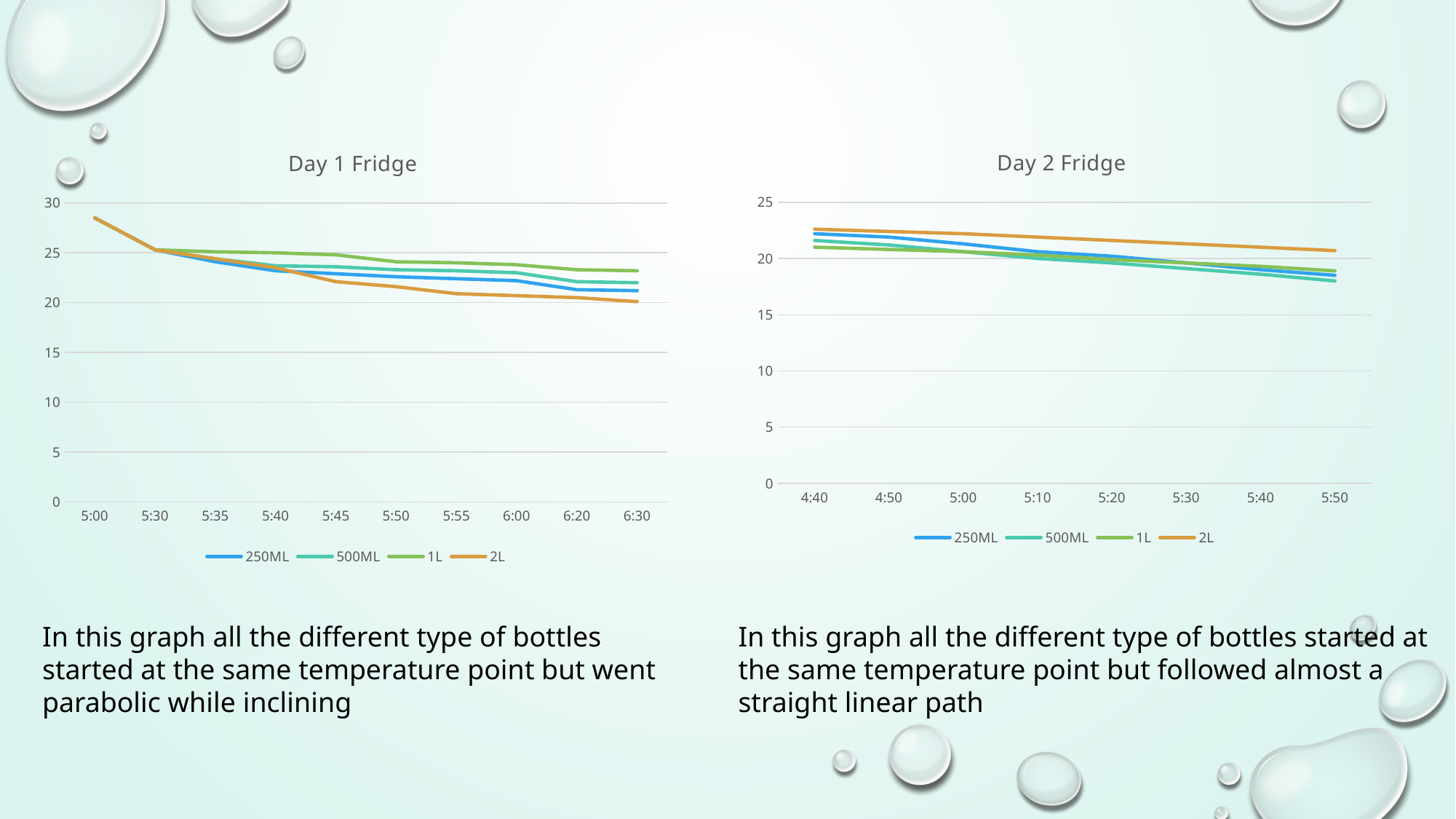
In the Day 1 Fridge chart, is the value for 2L at 5:00 greater or less than 25? greater In the Day 1 Fridge chart, is the value for 1L at 6:30 greater or less than 20? greater What kind of chart is the Day 1 Fridge chart? line chart In the Day 2 Fridge chart, is the value for 500ML at 5:50 greater or less than 20? less In the Day 2 Fridge chart, which series is highest at 5:50? 2L How many series does the legend of the Day 1 Fridge chart list? 4 How many time points are on the x axis of the Day 1 Fridge chart? 10 In the Day 1 Fridge chart, which series is lowest at 6:30? 2L In the Day 1 Fridge chart, do the values rise or fall from 5:00 to 6:30? fall In the Day 1 Fridge chart, which series is highest at 6:30? 1L What is the title of the chart on the right side of the slide? Day 2 Fridge How many time points are on the x axis of the Day 2 Fridge chart? 8